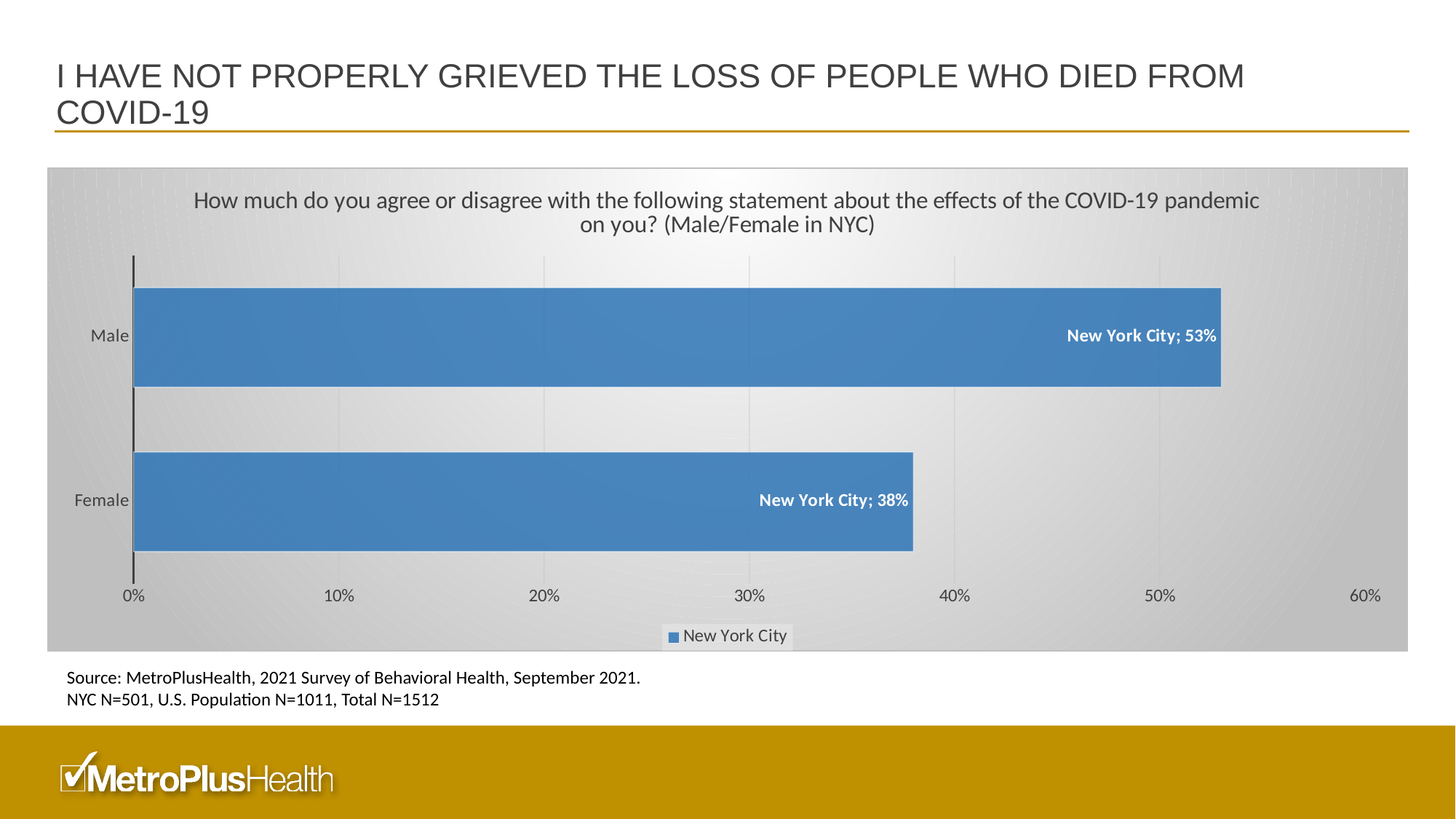
Is the value for Female greater or less than 40%? less Which is larger, the value for Male or the value for Female? Male How many categories are shown in the chart? 2 Is the value for Male greater or less than 50%? greater What is the difference between the Male and Female values? 15% What kind of chart is shown on the slide? Bar chart How many series does the legend list? 1 What is the value for Female? 38% Which category has the highest value? Male What series name appears in the chart legend? New York City Which category has the lowest value? Female What is the value for Male? 53%